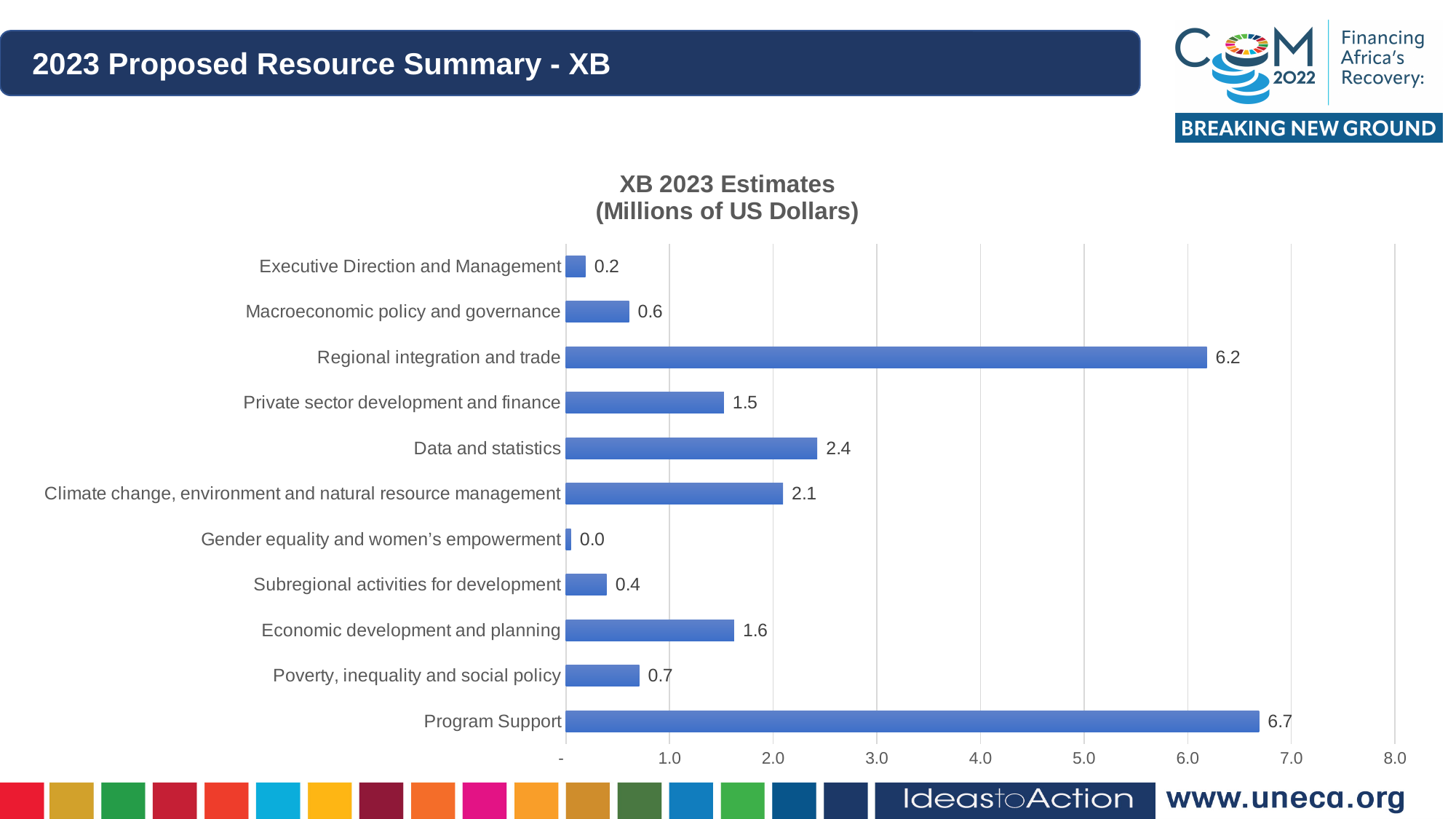
What is the difference between the values for Economic development and planning and Subregional activities for development? 1.2 What is the value for Regional integration and trade? 6.2 What is the difference between the values for Program Support and Regional integration and trade? 0.5 How many categories are shown in the chart? 11 Which is larger, the value for Data and statistics or the value for Climate change, environment and natural resource management? Data and statistics Which category has the lowest value? Gender equality and women’s empowerment Is the value for Private sector development and finance greater or less than 1.0? greater What is the title of the chart? XB 2023 Estimates (Millions of US Dollars) Which category has the highest value? Program Support What is the value for Data and statistics? 2.4 What kind of chart is shown on the slide? Bar chart What is the value for Poverty, inequality and social policy? 0.7